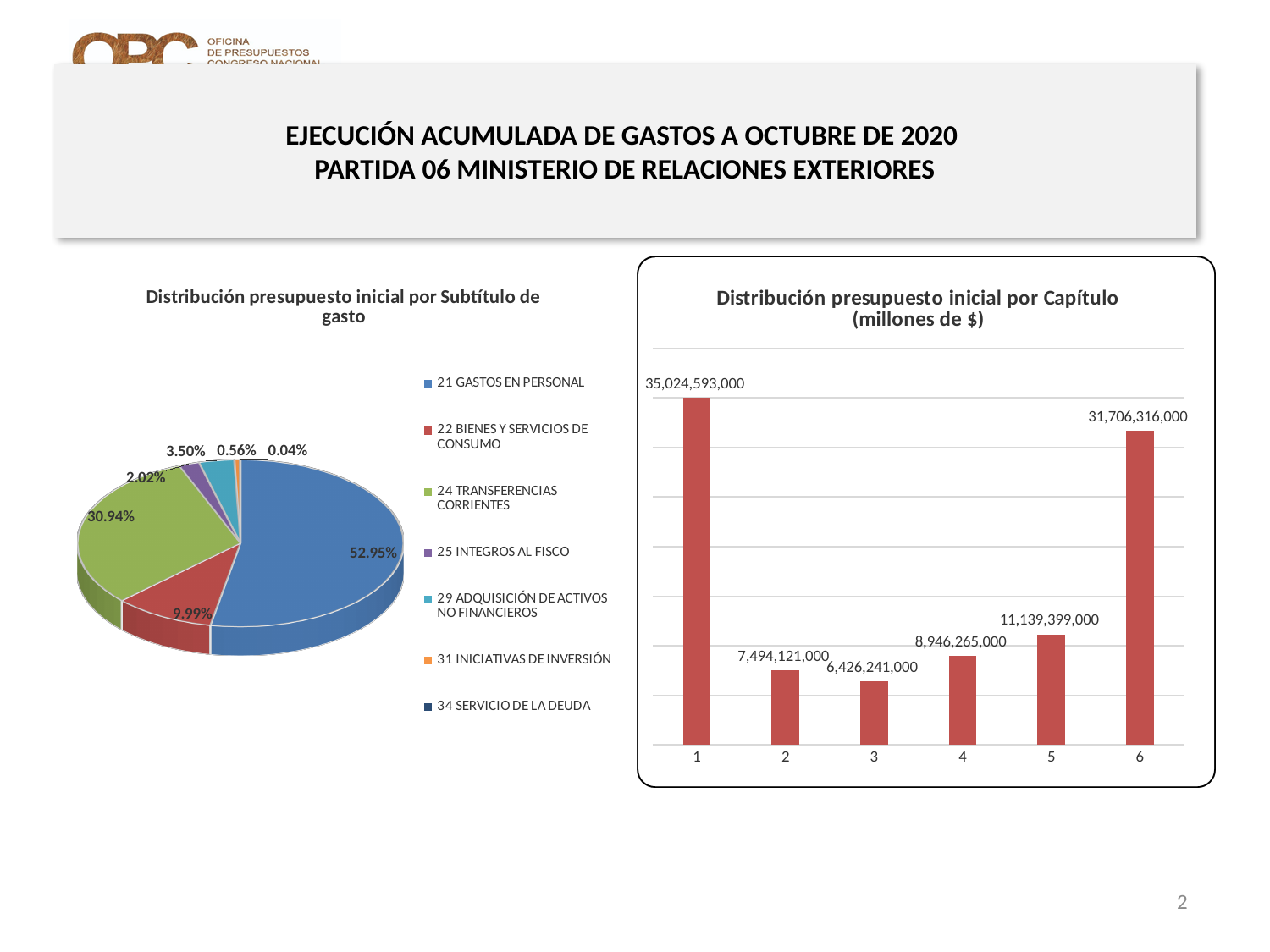
In the bar chart 'Distribución presupuesto inicial por Capítulo', what is the difference between the values for category 1 and category 6? 3,318,277,000 In the bar chart 'Distribución presupuesto inicial por Capítulo', what is the value for category 5? 11,139,399,000 How many entries does the legend of the pie chart 'Distribución presupuesto inicial por Subtítulo de gasto' list? 7 In the bar chart 'Distribución presupuesto inicial por Capítulo', which is larger, the value for category 2 or category 4? 4 In the pie chart 'Distribución presupuesto inicial por Subtítulo de gasto', what share does 21 GASTOS EN PERSONAL have? 52.95% In the bar chart 'Distribución presupuesto inicial por Capítulo', which category has the highest value? 1 How many categories are shown in the bar chart 'Distribución presupuesto inicial por Capítulo'? 6 In the pie chart 'Distribución presupuesto inicial por Subtítulo de gasto', what share does 24 TRANSFERENCIAS CORRIENTES have? 30.94% In the pie chart 'Distribución presupuesto inicial por Subtítulo de gasto', which legend entry has the smallest share? 34 SERVICIO DE LA DEUDA In the bar chart 'Distribución presupuesto inicial por Capítulo', what is the value for category 1? 35,024,593,000 What kind of chart is 'Distribución presupuesto inicial por Capítulo'? bar chart In the bar chart 'Distribución presupuesto inicial por Capítulo', which category has the lowest value? 3